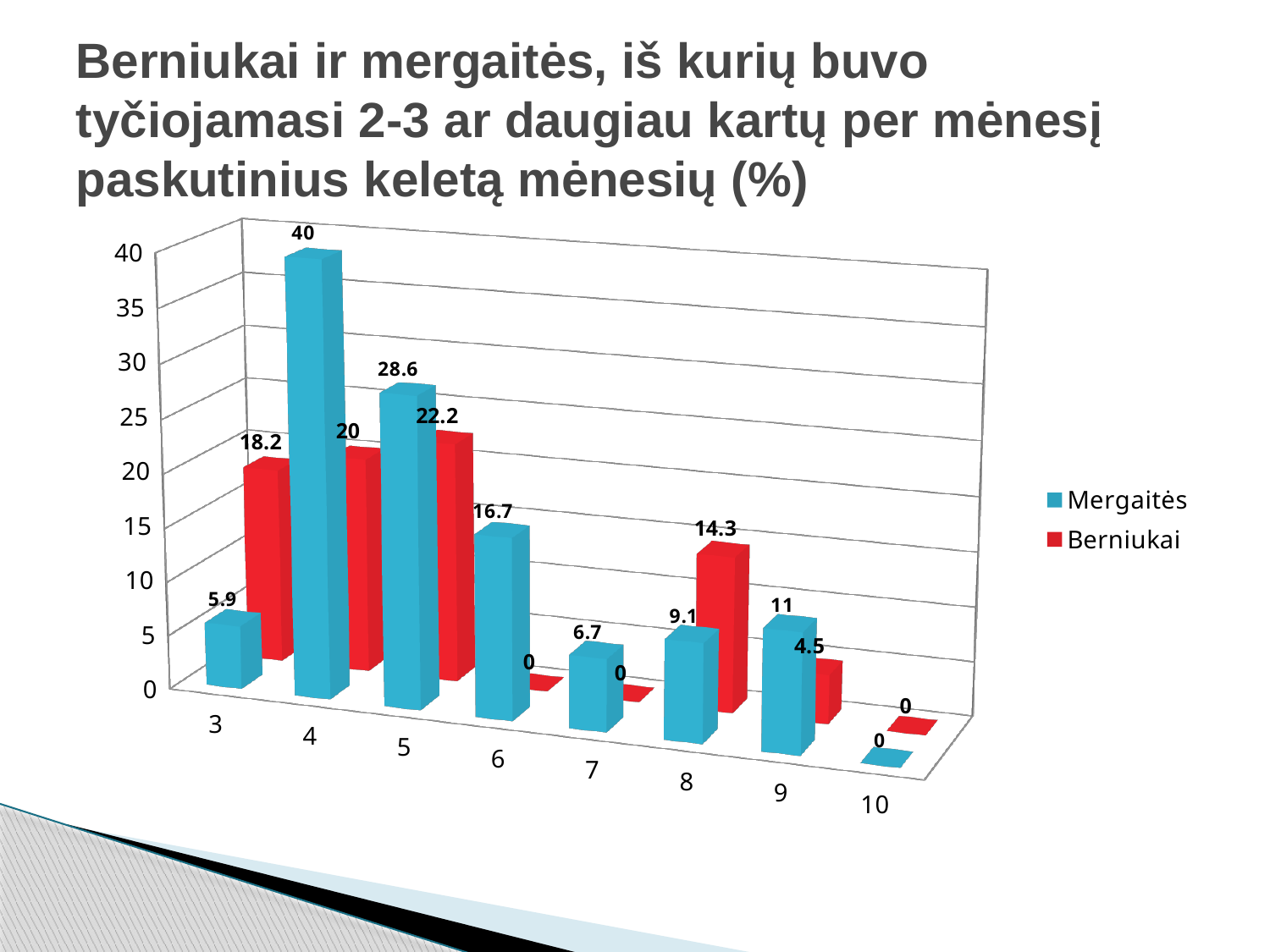
What is the value for Mergaitės in category 4? 40 What is the difference between the Mergaitės and Berniukai values in category 3? 12.3 Which colour represents the Berniukai series? Red What is the value for Mergaitės in category 6? 16.7 What is the value for Berniukai in category 8? 14.3 Which category has the highest value for Berniukai? 5 Which category has the highest value for Mergaitės? 4 What is the value for Berniukai in category 5? 22.2 In category 9, which series has the larger value, Mergaitės or Berniukai? Mergaitės How many categories are shown on the x axis? 8 What kind of chart is shown on the slide? Bar chart How many series does the legend list? 2